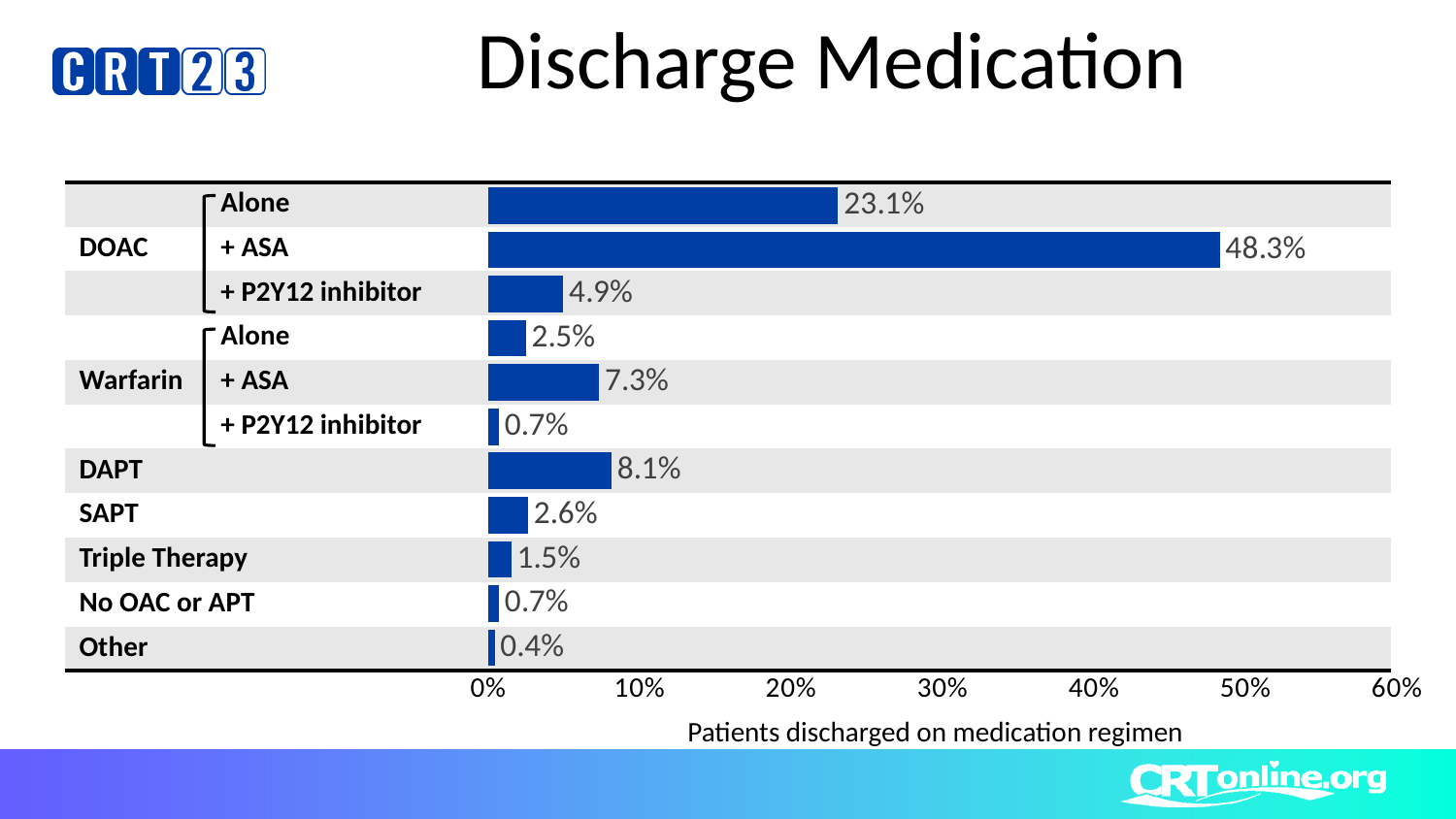
What type of chart is shown on the slide? Bar chart What is the value for DAPT? 8.1% What is the x-axis label of the chart? Patients discharged on medication regimen Is the value for DOAC alone greater or less than 20%? greater What percentage of patients were discharged on DOAC alone? 23.1% Which is larger, DAPT or Warfarin + ASA? DAPT What is the difference between DOAC + ASA and DOAC alone? 25.2% Which medication regimen has the highest percentage of patients? DOAC + ASA How many medication regimen categories are shown in the chart? 11 Which medication regimen has the lowest percentage of patients? Other What percentage of patients were discharged on DOAC + ASA? 48.3% What is the value for Warfarin + ASA? 7.3%